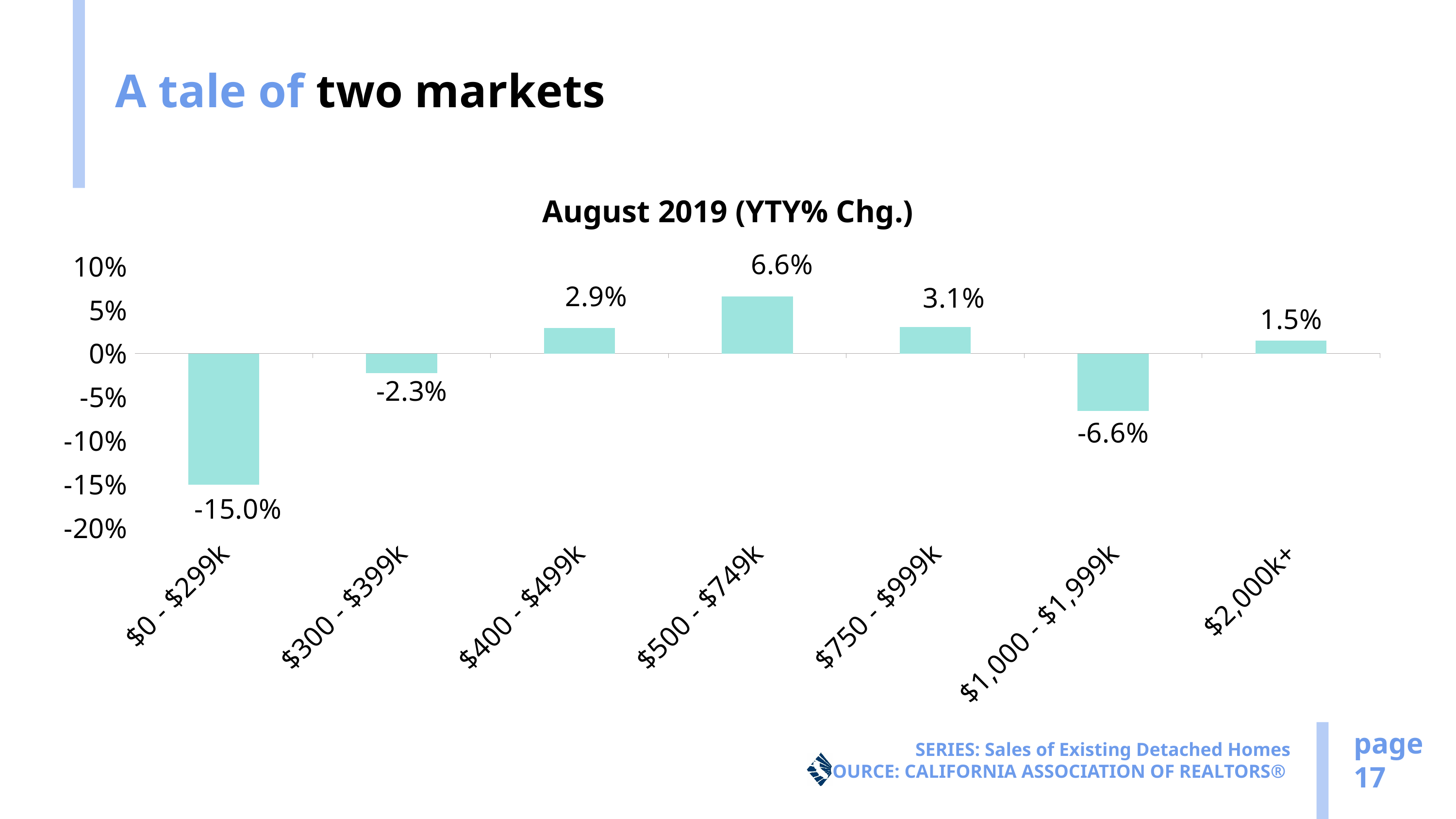
Which price range has the highest YTY% change? $500 - $749k Which has a larger YTY% change, $300 - $399k or $2,000k+? $2,000k+ What is the YTY% change for the $500 - $749k price range? 6.6% What is the title of the chart? August 2019 (YTY% Chg.) What is the difference between the YTY% change for $750 - $999k and $400 - $499k? 0.2% What is the YTY% change for the $1,000 - $1,999k price range? -6.6% Which price range has the lowest YTY% change? $0 - $299k What kind of chart is shown on the slide? Bar chart What is the YTY% change for the $2,000k+ price range? 1.5% What is the YTY% change for the $0 - $299k price range? -15.0% How many price ranges show a negative YTY% change? 3 How many price ranges are shown in the chart? 7